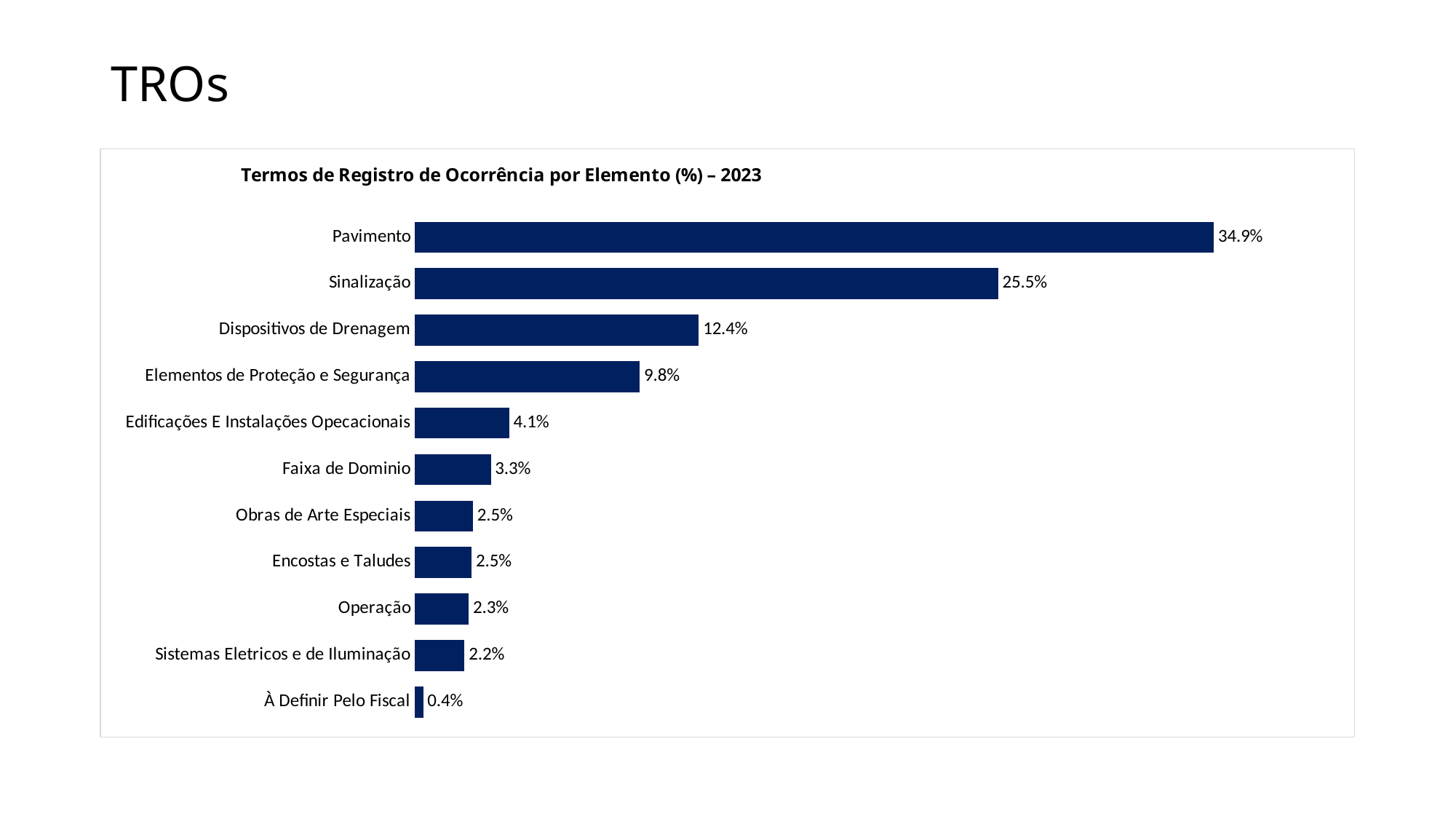
What is the value for Sistemas Eletricos e de Iluminação? 2.2% Which category has the highest value? Pavimento What kind of chart is shown on the slide? Bar chart Which category has the lowest value? À Definir Pelo Fiscal What is the title of the chart? Termos de Registro de Ocorrência por Elemento (%) – 2023 Which is larger, the value for Edificações E Instalações Opecacionais or the value for Operação? Edificações E Instalações Opecacionais What is the value for Faixa de Dominio? 3.3% What is the difference between the values for Pavimento and Sinalização? 9.4% What is the value for Pavimento? 34.9% What is the value for Dispositivos de Drenagem? 12.4% What is the difference between the values for Dispositivos de Drenagem and Elementos de Proteção e Segurança? 2.6% How many categories are shown in the chart? 11